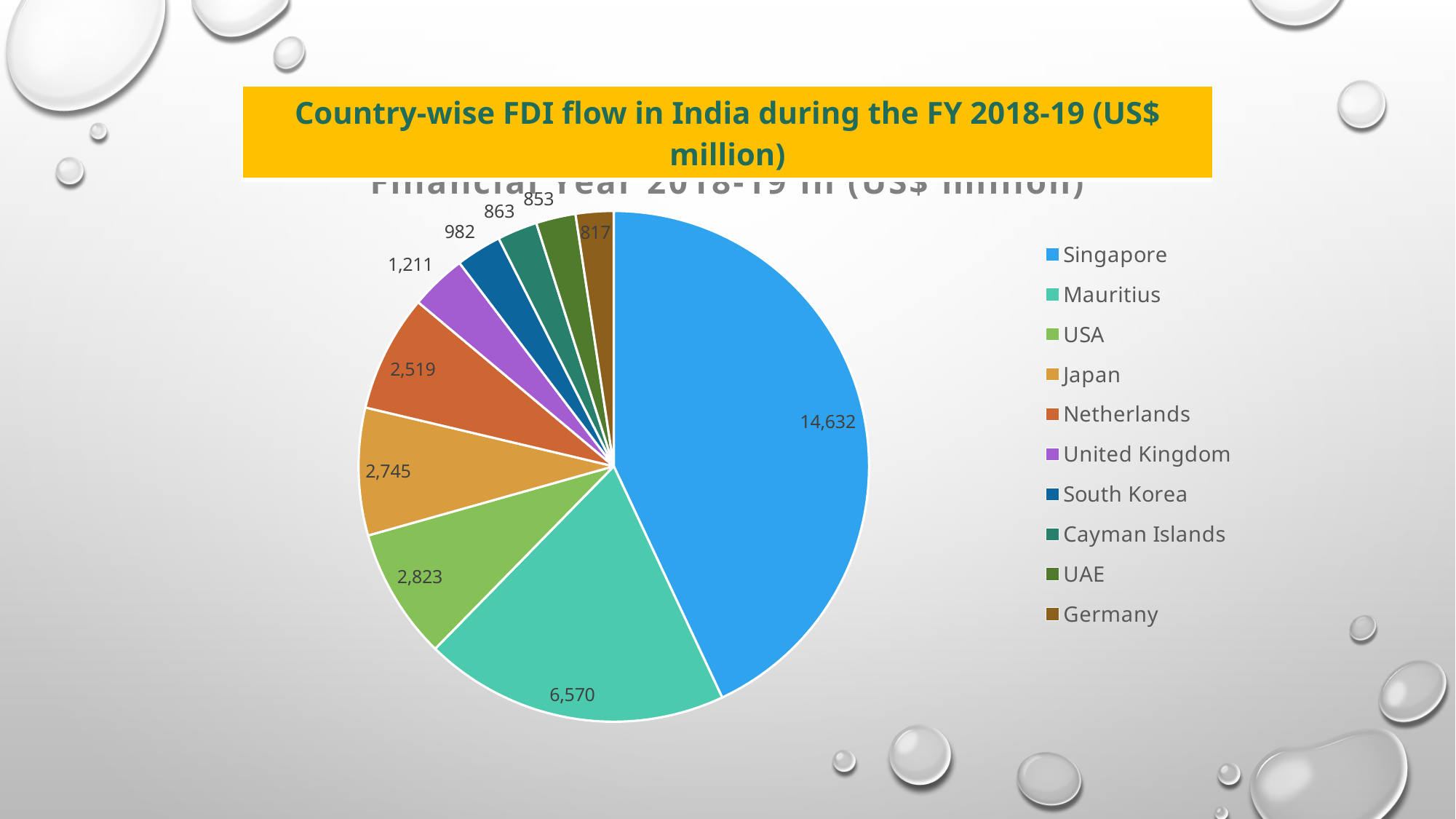
What is the title shown in the yellow box above the chart? Country-wise FDI flow in India during the FY 2018-19 (US$ million) What is the FDI value for the United Kingdom? 1,211 What is the FDI value for Singapore? 14,632 How many countries are shown in the pie chart? 10 Which country has the smallest FDI flow in the chart? Germany What is the difference between the FDI values for Singapore and Mauritius? 8,062 What is the FDI value for Mauritius? 6,570 What type of chart is shown on the slide? Pie chart What is the difference between the FDI values for USA and Japan? 78 Which country has the largest FDI flow in the chart? Singapore What is the FDI value for Netherlands? 2,519 Which has a larger FDI value, South Korea or Cayman Islands? South Korea